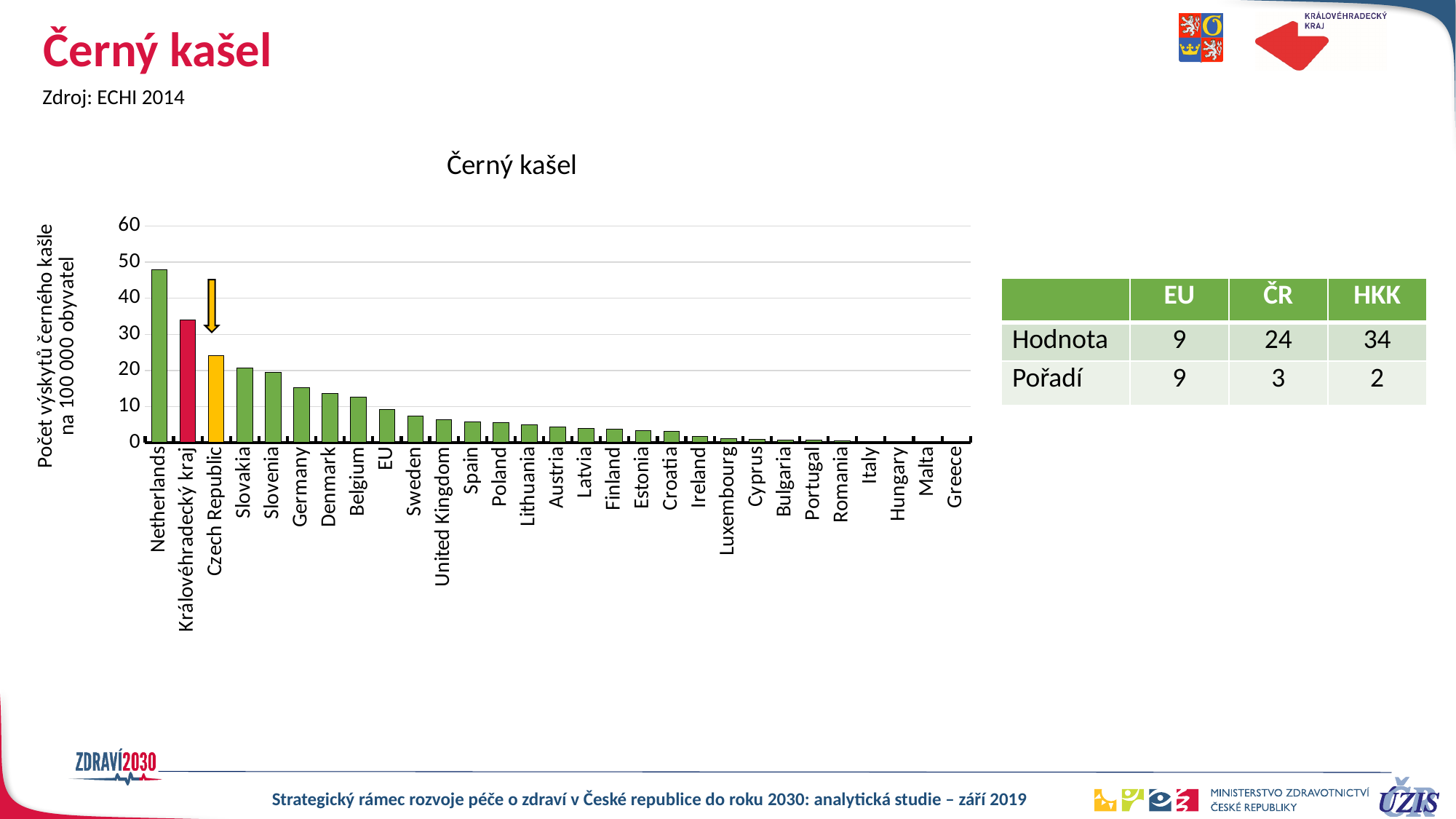
Is the value for Slovakia greater or less than 30? less What is the value for Czech Republic? 24 What is the difference between the values for Královéhradecký kraj and Czech Republic? 10 What is the value for Královéhradecký kraj? 34 How many categories are shown on the x axis of the chart? 29 Do the values rise or fall from left to right along the x axis? fall Is the value for Netherlands greater or less than 40? greater Which has a larger value, Germany or Belgium? Germany What is the title of the chart? Černý kašel Which category has the highest value in the chart? Netherlands What kind of chart is shown on the slide? bar chart What is the value for EU? 9